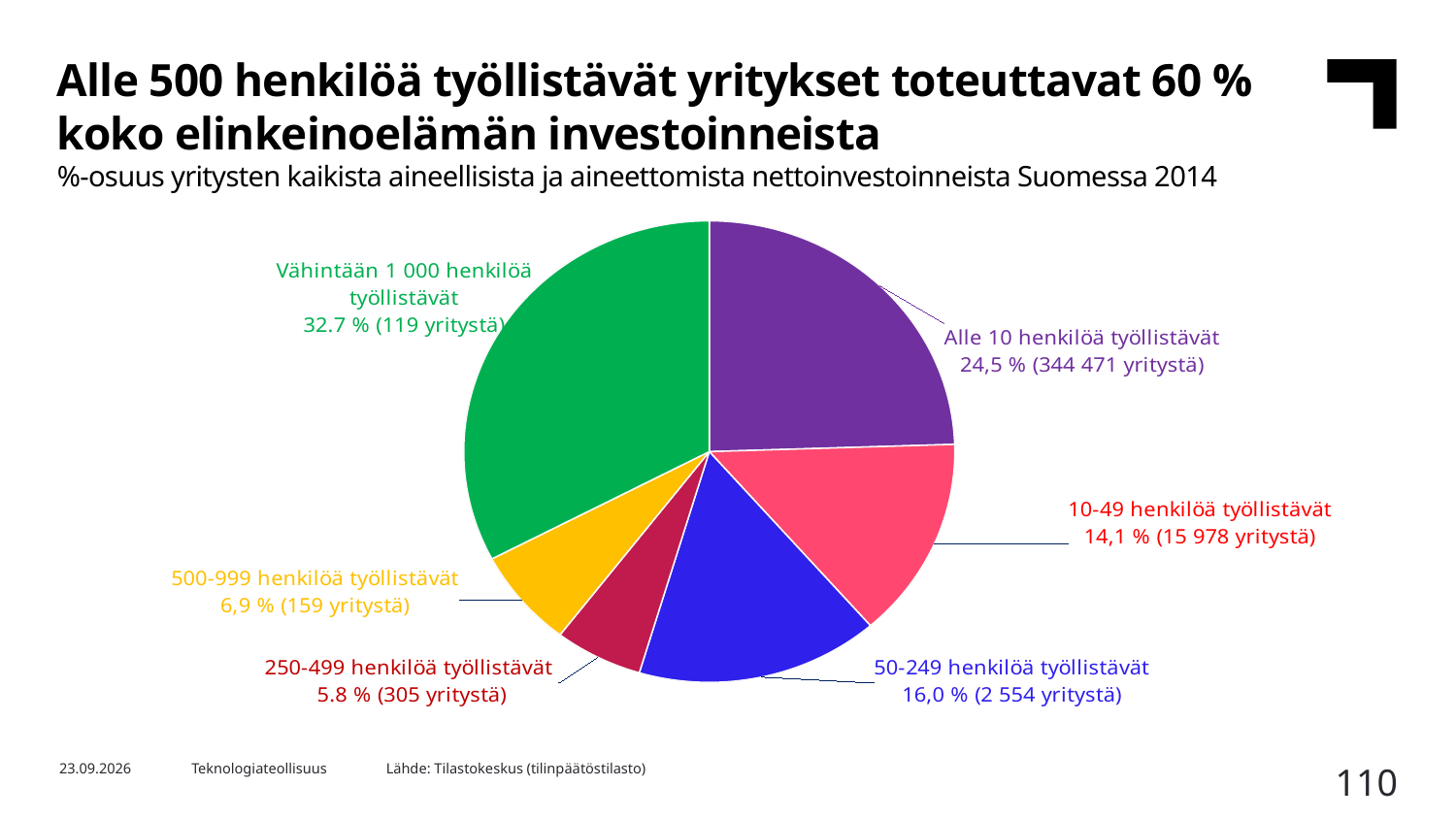
What share of net investments is attributed to companies employing fewer than 10 people (Alle 10 henkilöä työllistävät)? 24,5 % Which company size group has the smallest share of net investments? 250-499 henkilöä työllistävät What is the difference in percentage points between the share of companies employing at least 1,000 people (32.7 %) and companies employing fewer than 10 people (24,5 %)? 8.2 percentage points What type of chart is shown on the slide? Pie chart What share of net investments is attributed to companies employing 500-999 people? 6,9 % Which group has a larger share of net investments: 10-49 henkilöä työllistävät or 50-249 henkilöä työllistävät? 50-249 henkilöä työllistävät Which company size group has the largest share of net investments? Vähintään 1 000 henkilöä työllistävät How many companies are in the 50-249 henkilöä työllistävät group according to the chart label? 2 554 yritystä What share of net investments is attributed to companies employing at least 1,000 people (Vähintään 1 000 henkilöä työllistävät)? 32.7 % What is the difference in percentage points between the 500-999 group (6,9 %) and the 250-499 group (5.8 %)? 1.1 percentage points How many company size groups are shown in the pie chart? 6 What colour is the slice for Alle 10 henkilöä työllistävät? Purple